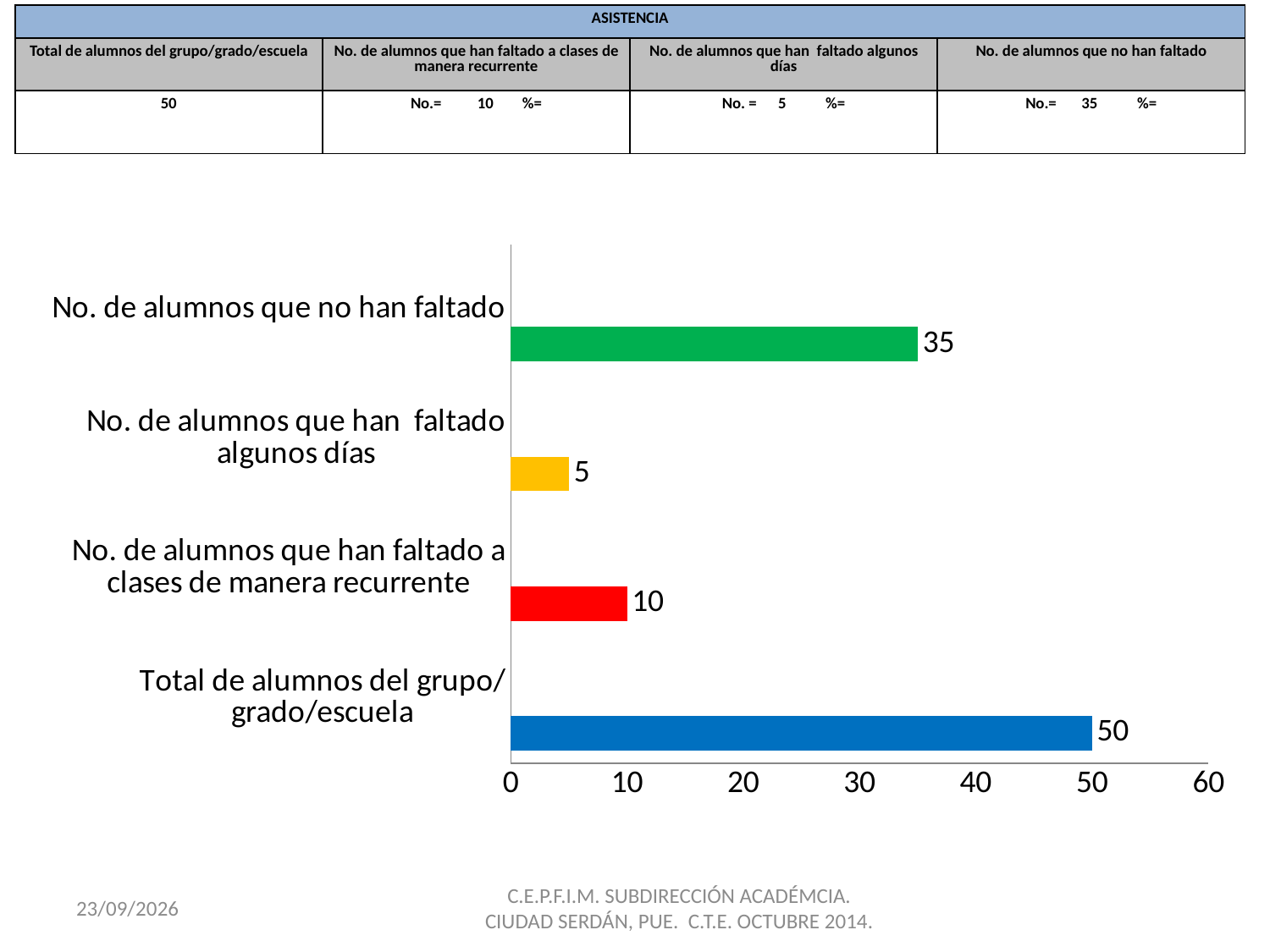
What colour is the bar for "No. de alumnos que han faltado a clases de manera recurrente"? red Which category has the highest value? Total de alumnos del grupo/grado/escuela What kind of chart is shown on the slide? bar chart Which is larger: the value for "No. de alumnos que han faltado a clases de manera recurrente" or "No. de alumnos que han faltado algunos días"? No. de alumnos que han faltado a clases de manera recurrente What is the value for "Total de alumnos del grupo/grado/escuela"? 50 What is the value for "No. de alumnos que han faltado algunos días"? 5 Is the value for "No. de alumnos que no han faltado" greater or less than 30? greater What is the value for "No. de alumnos que han faltado a clases de manera recurrente"? 10 Which category has the lowest value? No. de alumnos que han faltado algunos días How many categories are shown in the chart? 4 What is the difference between the values for "No. de alumnos que no han faltado" and "No. de alumnos que han faltado a clases de manera recurrente"? 25 What is the value for "No. de alumnos que no han faltado"? 35